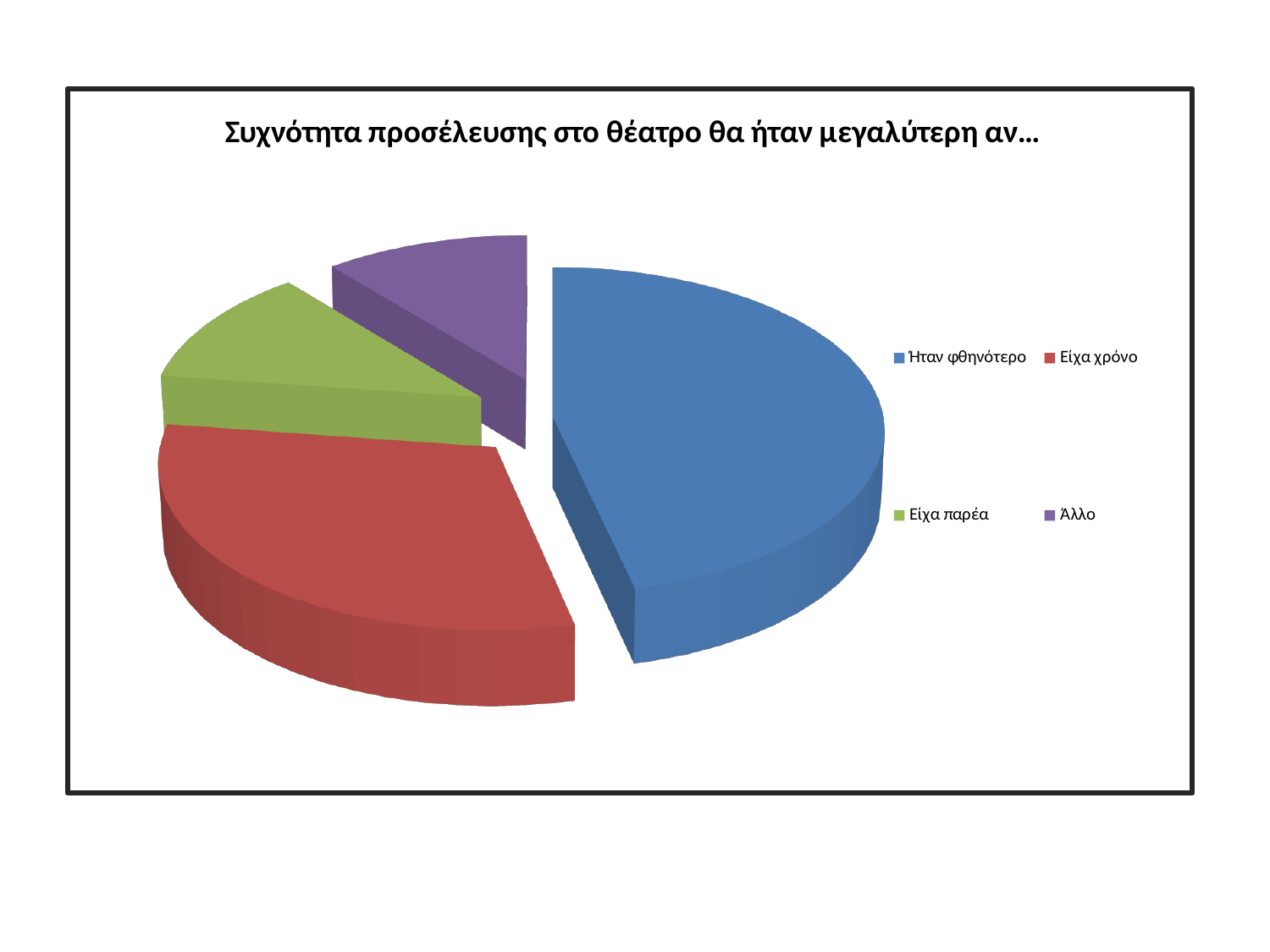
Which category has the largest slice of the pie? Ήταν φθηνότερο What is the title of the chart? Συχνότητα προσέλευσης στο θέατρο θα ήταν μεγαλύτερη αν… What kind of chart is shown on the slide? Pie chart How many entries does the legend list? 4 How many slices does the pie chart have? 4 What colour is the slice for Είχα παρέα? Green Which slice is larger, Είχα χρόνο or Είχα παρέα? Είχα χρόνο Which slice is larger, Ήταν φθηνότερο or Είχα χρόνο? Ήταν φθηνότερο